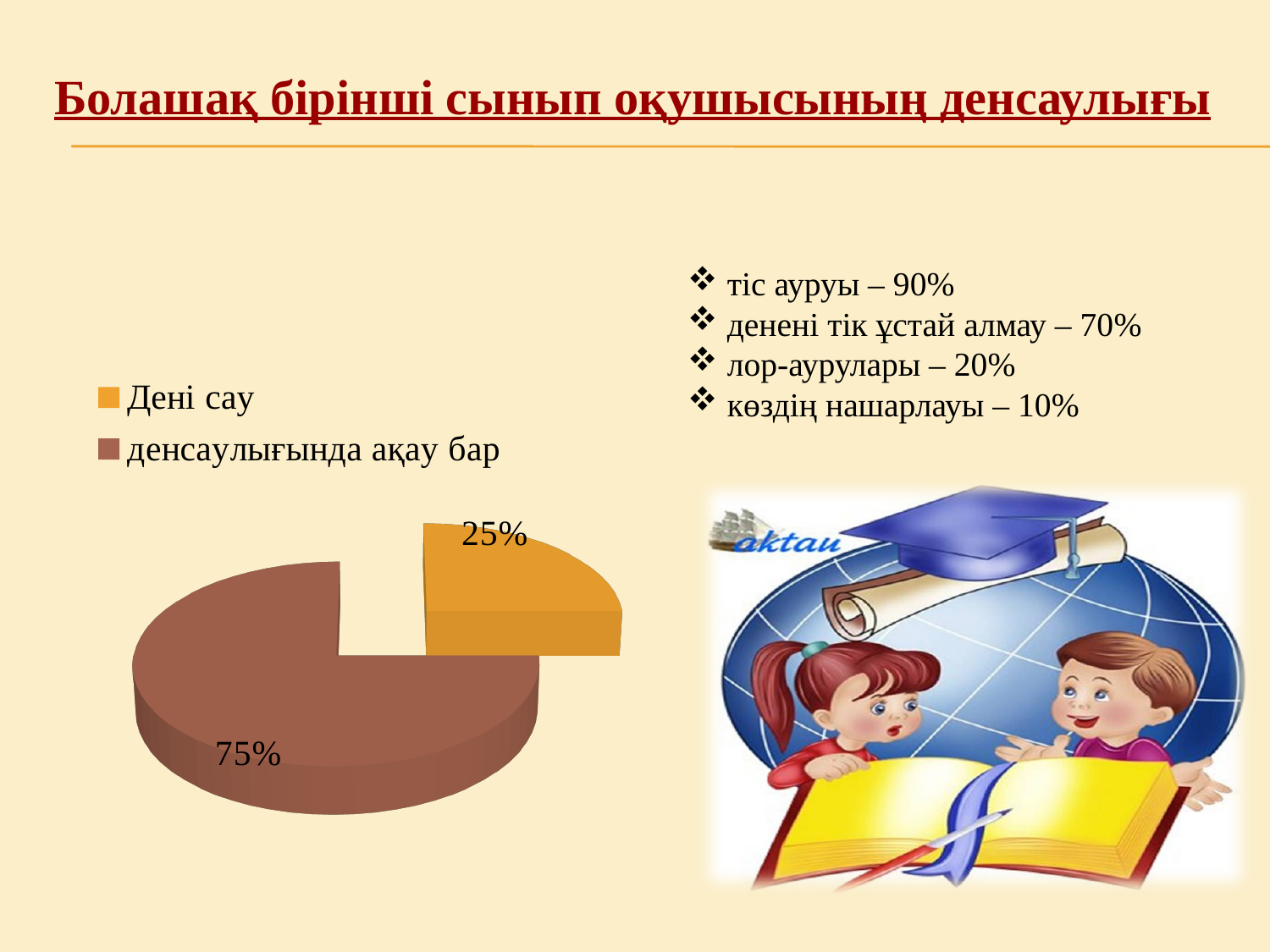
What is the difference between the "денсаулығында ақау бар" and "Дені сау" slices? 50% How many entries does the chart legend list? 2 What share of the pie does "денсаулығында ақау бар" represent? 75% What share of the pie does "Дені сау" represent? 25% Which slice of the pie chart is the smallest? Дені сау How many slices does the pie chart have? 2 Which slice of the pie chart is the largest? денсаулығында ақау бар What colour is the "Дені сау" slice in the pie chart? orange What is the value shown for the "Дені сау" slice? 25% What is the value shown for the "денсаулығында ақау бар" slice? 75% Which is larger, the "Дені сау" slice or the "денсаулығында ақау бар" slice? денсаулығында ақау бар What kind of chart is shown on the slide? pie chart